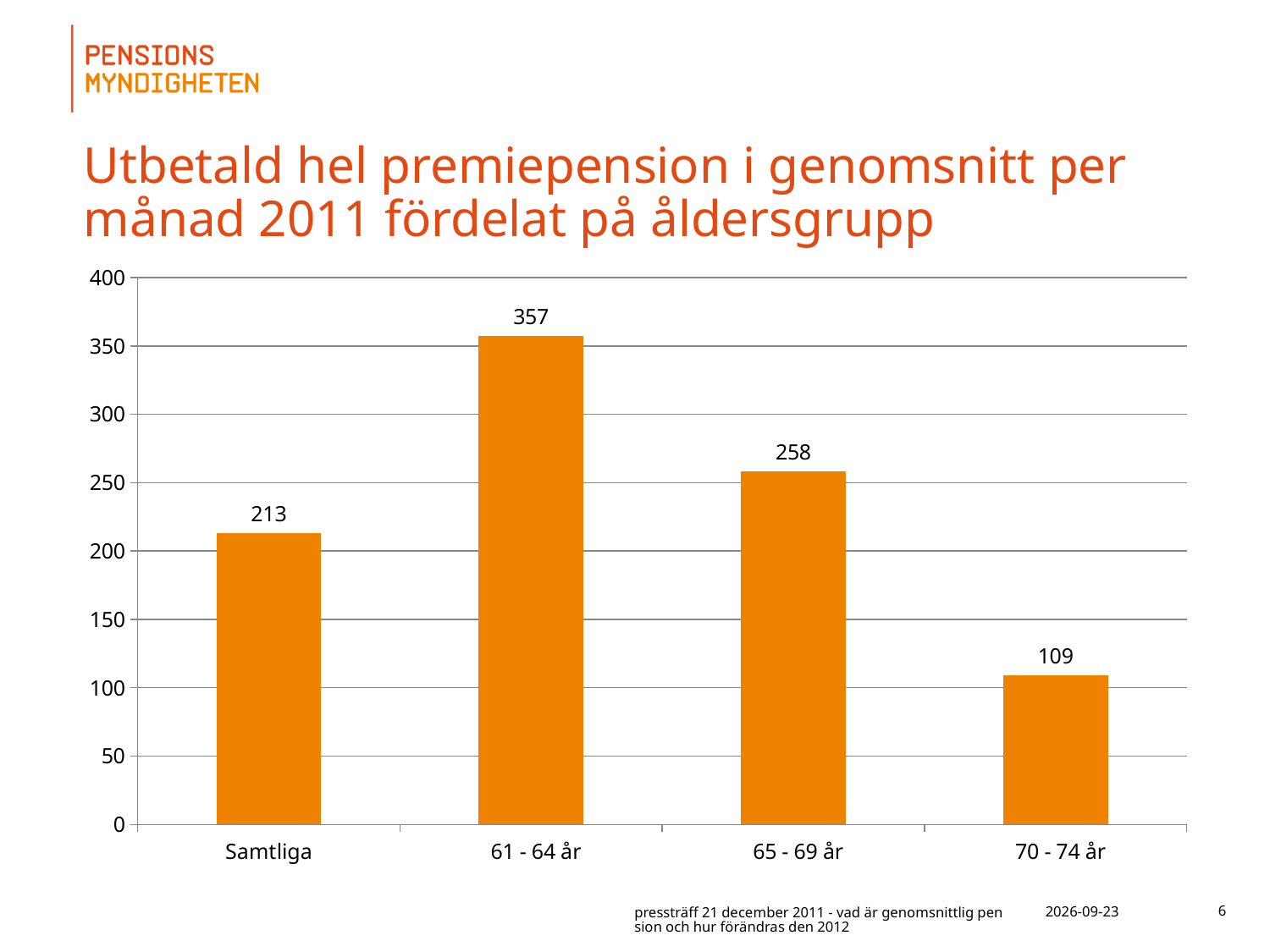
What is the difference between the values for Samtliga and 70 - 74 år? 104 Which category has the lowest value? 70 - 74 år What is the value for 61 - 64 år? 357 Which is larger, the value for Samtliga or the value for 65 - 69 år? 65 - 69 år What kind of chart is shown on the slide? bar chart What is the difference between the values for 61 - 64 år and 65 - 69 år? 99 What is the value for 65 - 69 år? 258 Is the value for 61 - 64 år greater or less than 300? greater How many categories are shown on the x axis? 4 Which category has the highest value? 61 - 64 år What is the value for Samtliga? 213 What is the value for 70 - 74 år? 109